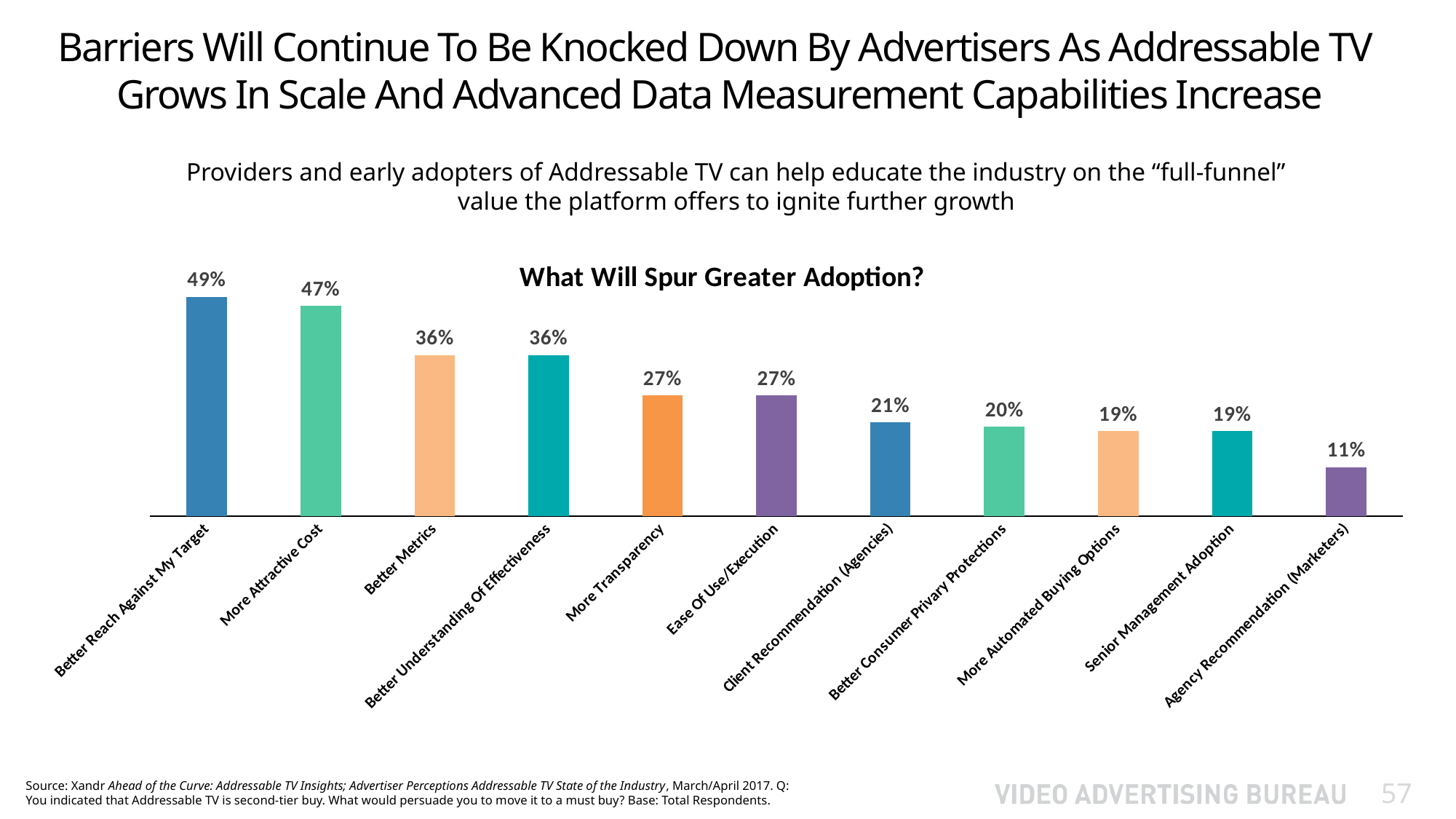
Which category has the lowest value? Agency Recommendation (Marketers) How many categories are shown in the chart? 11 Which is larger, Ease Of Use/Execution or Senior Management Adoption? Ease Of Use/Execution What is the value for More Transparency? 27% Which category has the highest value? Better Reach Against My Target What is the value for Better Consumer Privacy Protections? 20% What is the difference between Client Recommendation (Agencies) and Agency Recommendation (Marketers)? 10% What kind of chart is shown on the slide? Bar chart What is the title of the chart? What Will Spur Greater Adoption? What is the value for Better Reach Against My Target? 49% What is the difference between More Attractive Cost and Better Metrics? 11% What is the value for Agency Recommendation (Marketers)? 11%